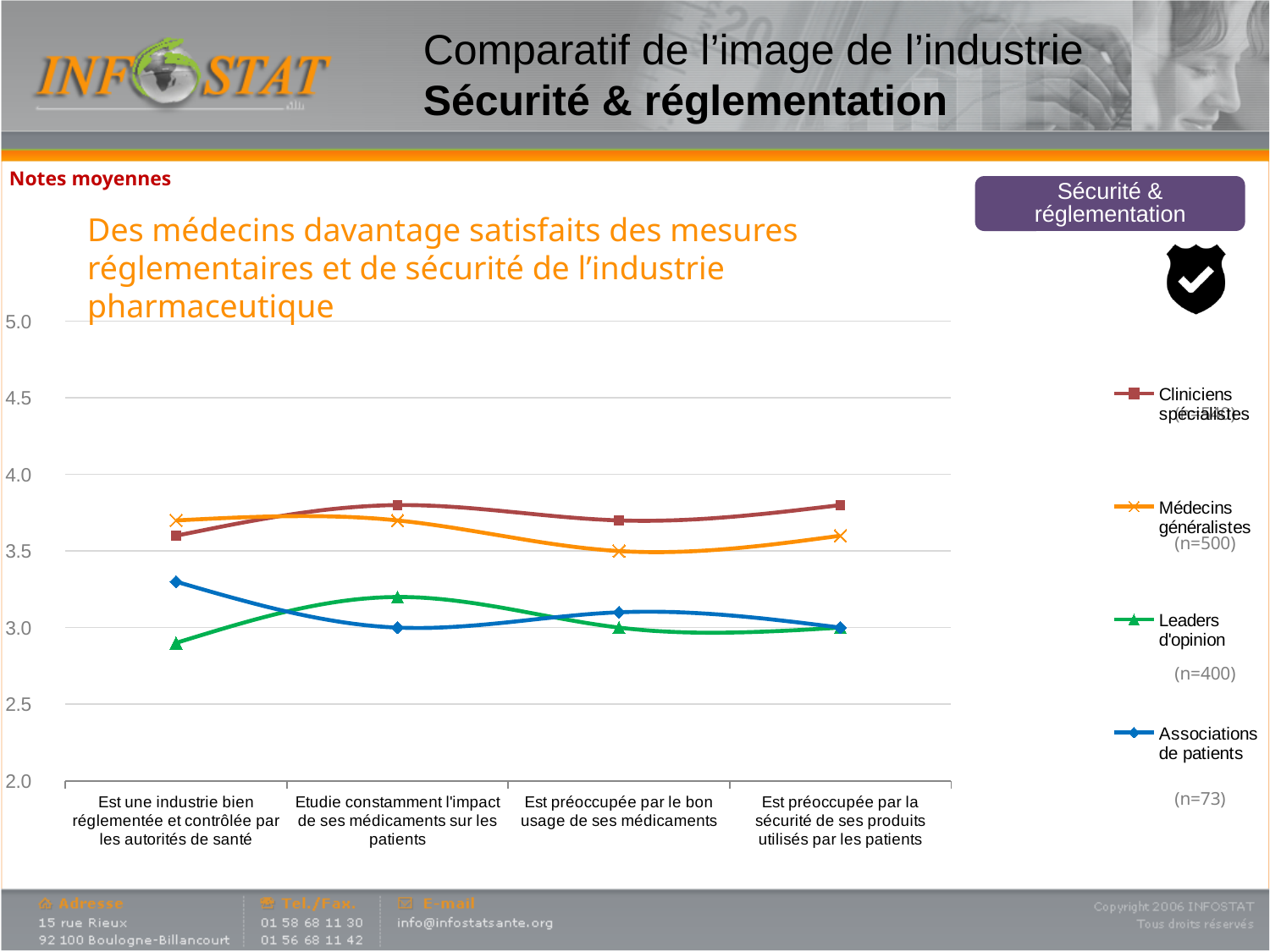
What is the value for Médecins généralistes on "Est préoccupée par le bon usage de ses médicaments"? 3.5 What is the value for Leaders d'opinion on "Est préoccupée par la sécurité de ses produits utilisés par les patients"? 3.0 Is the value for Leaders d'opinion on "Est une industrie bien réglementée et contrôlée par les autorités de santé" greater or less than 3.0? less Is the value for Associations de patients on "Est une industrie bien réglementée et contrôlée par les autorités de santé" greater or less than 3.0? greater On "Est une industrie bien réglementée et contrôlée par les autorités de santé", which is higher: Médecins généralistes or Leaders d'opinion? Médecins généralistes Is the value for Cliniciens spécialistes on "Etudie constamment l'impact de ses médicaments sur les patients" greater or less than 3.5? greater How many categories are shown along the x axis? 4 What kind of chart is shown on the slide? line chart Which series has the lowest value on "Est une industrie bien réglementée et contrôlée par les autorités de santé"? Leaders d'opinion How many series does the legend list? 4 Does the Associations de patients line rise or fall from the first category to the second? fall Which series has the highest value on "Est préoccupée par la sécurité de ses produits utilisés par les patients"? Cliniciens spécialistes